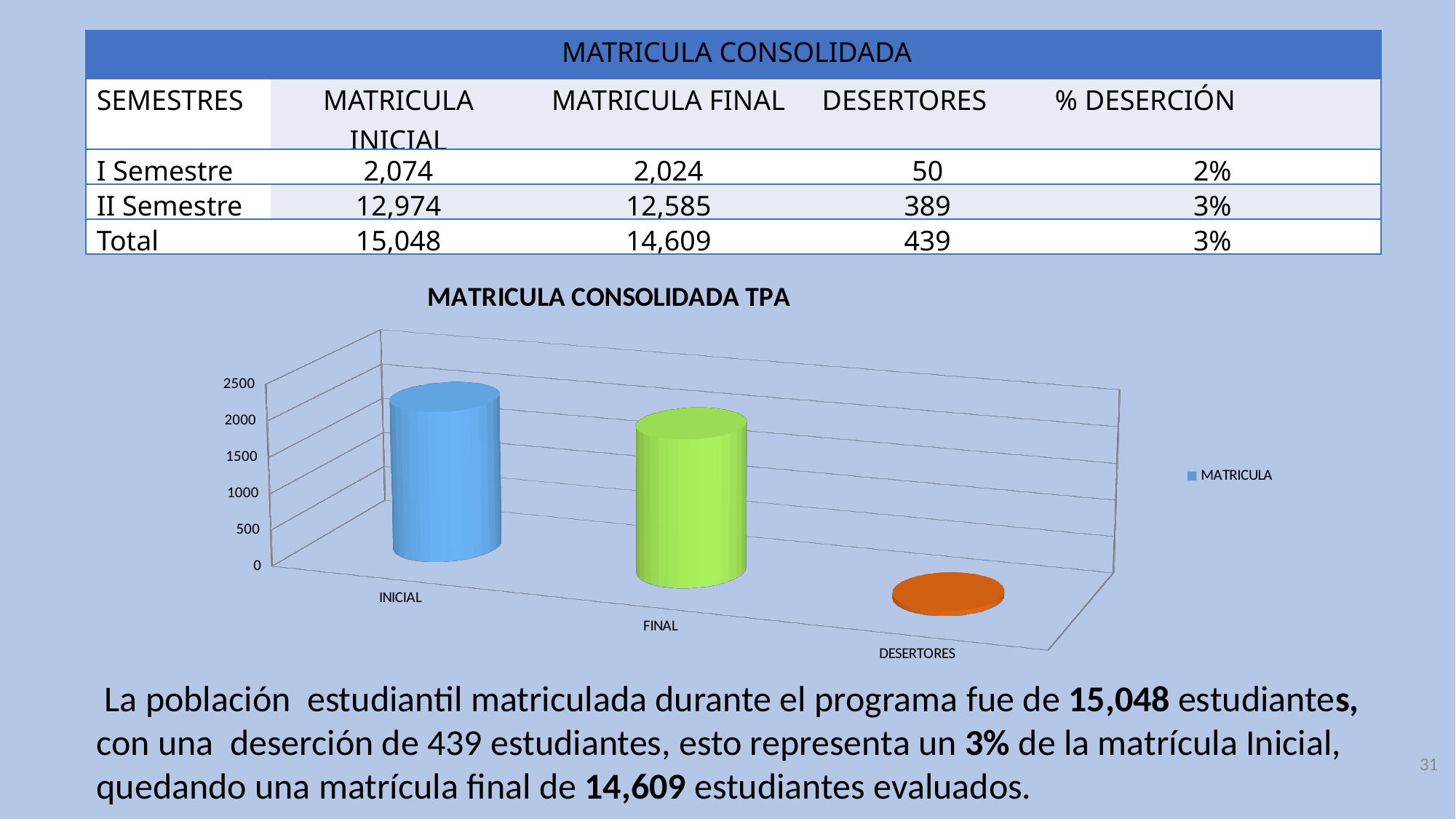
Which is larger in the chart, the value for FINAL or the value for DESERTORES? FINAL Is the value for FINAL greater or less than 1000? greater Which is larger in the chart, the value for INICIAL or the value for DESERTORES? INICIAL How many categories are plotted on the x axis of the chart? 3 What kind of chart is shown on the slide? bar chart Which category has the lowest value in the chart? DESERTORES What series name is shown in the chart legend? MATRICULA Is the value for INICIAL greater or less than 1500? greater How many series does the chart legend list? 1 Is the value for DESERTORES greater or less than 500? less Do the values rise or fall moving from INICIAL to DESERTORES along the x axis? fall What is the title of the chart? MATRICULA CONSOLIDADA TPA